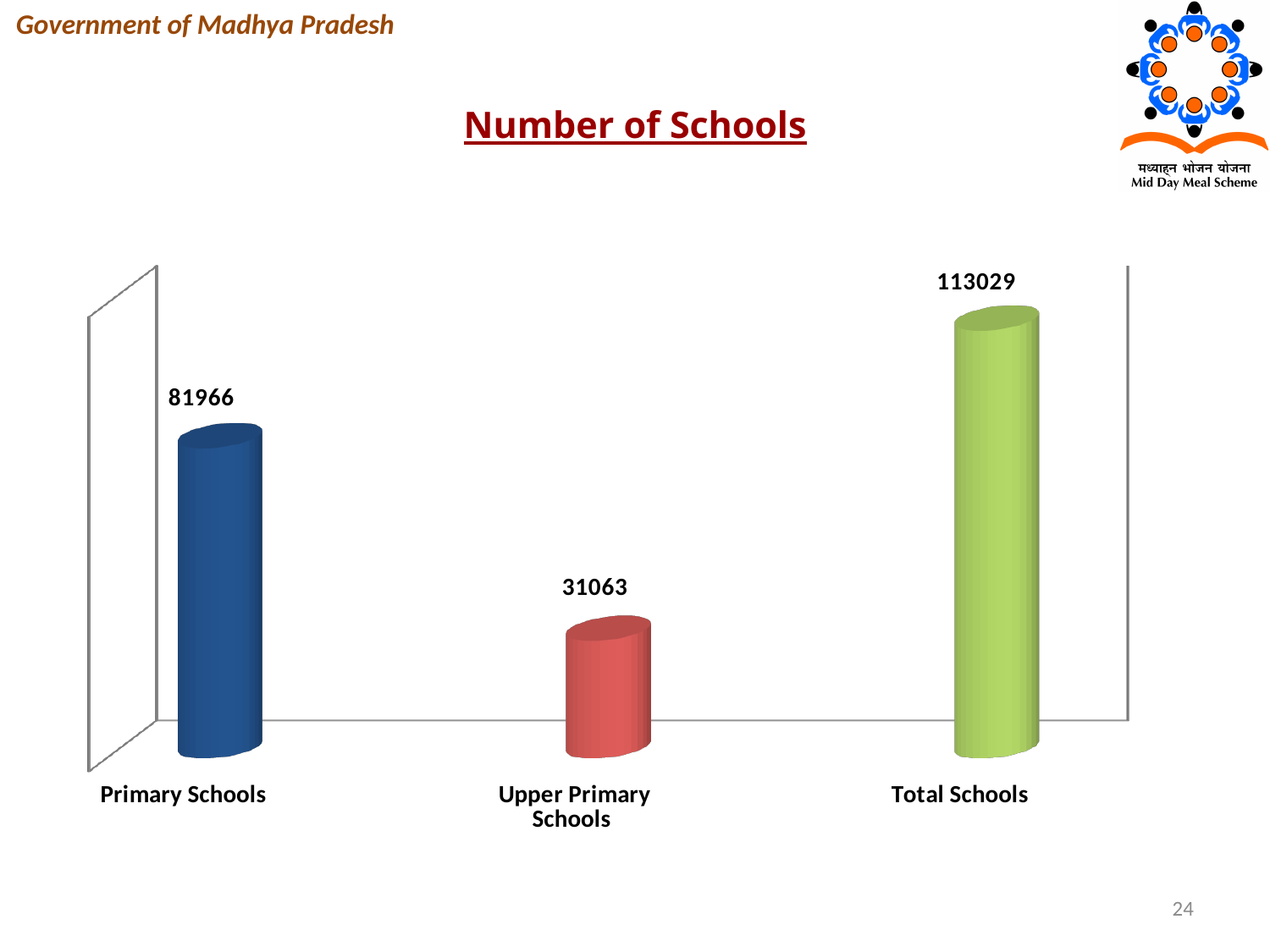
Which is larger, the value for Primary Schools or the value for Upper Primary Schools? Primary Schools What colour is the bar for Total Schools? Green How many categories are shown in the chart? 3 Which category has the lowest value? Upper Primary Schools What is the value for Upper Primary Schools? 31063 What is the difference between the values for Total Schools and Primary Schools? 31063 What is the title of the chart? Number of Schools What is the difference between the values for Primary Schools and Upper Primary Schools? 50903 Which category has the highest value? Total Schools What is the value for Primary Schools? 81966 What is the value for Total Schools? 113029 What kind of chart is shown on the slide? Bar chart